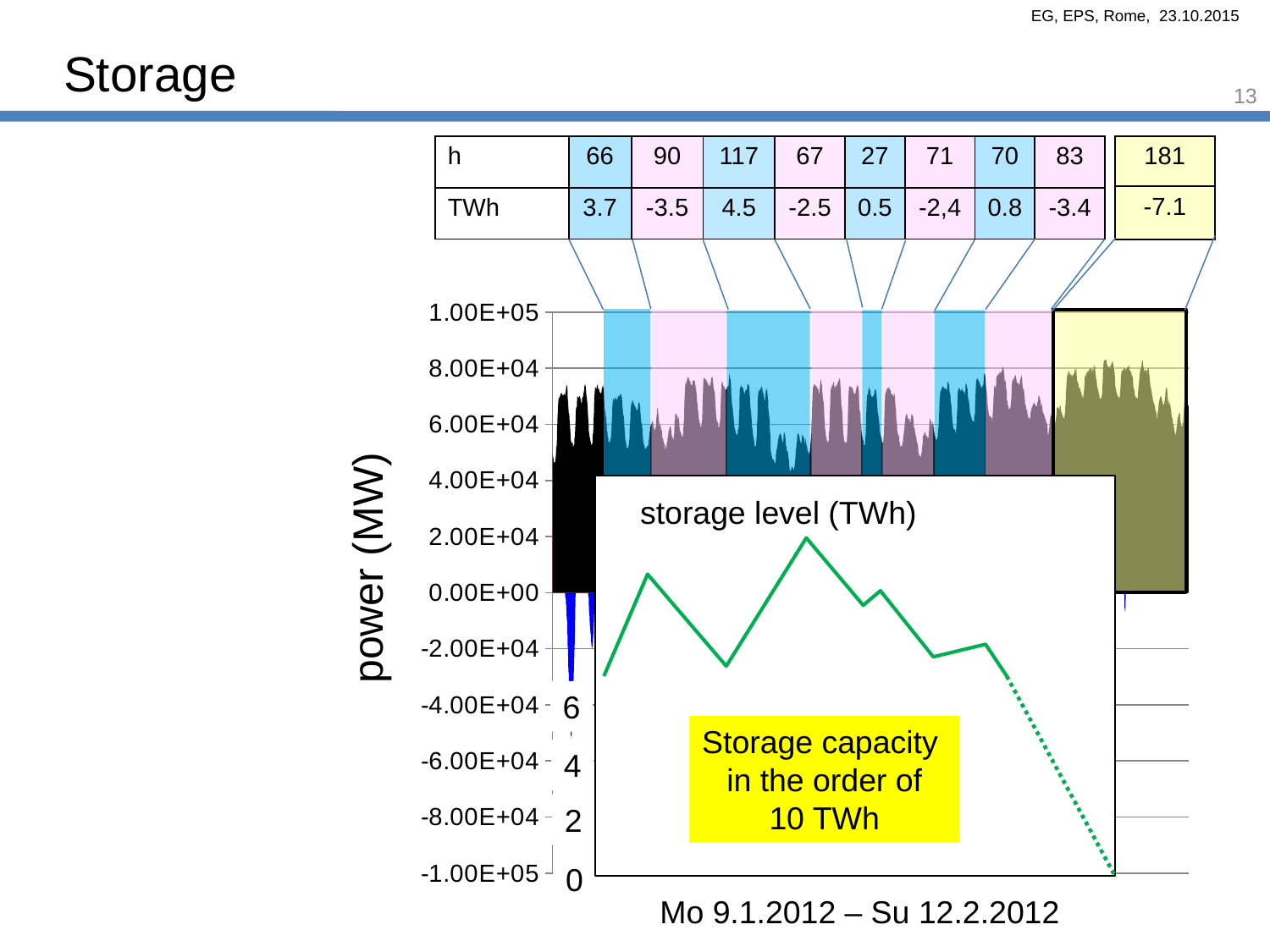
In the table above the chart, which is larger: the TWh value for the 66 h segment or for the 117 h segment? 117 h segment (4.5) In the table above the chart, what is the TWh value for the segment with 117 h? 4.5 In the table above the chart, what is the TWh value for the segment with 181 h? -7.1 In the table above the chart, what is the lowest value in the TWh row? -7.1 What is the label on the vertical axis of the large chart? power (MW) How many segments (columns of values) does the table above the chart contain? 9 According to the yellow box on the chart, what is the storage capacity in the order of? 10 TWh In the table above the chart, what is the difference in hours between the 117 h segment and the 66 h segment? 51 In the table above the chart, what is the lowest value in the h row? 27 In the table above the chart, what is the highest value in the TWh row? 4.5 In the table above the chart, what is the highest value in the h row? 181 What kind of chart is the inset titled "storage level (TWh)"? line chart